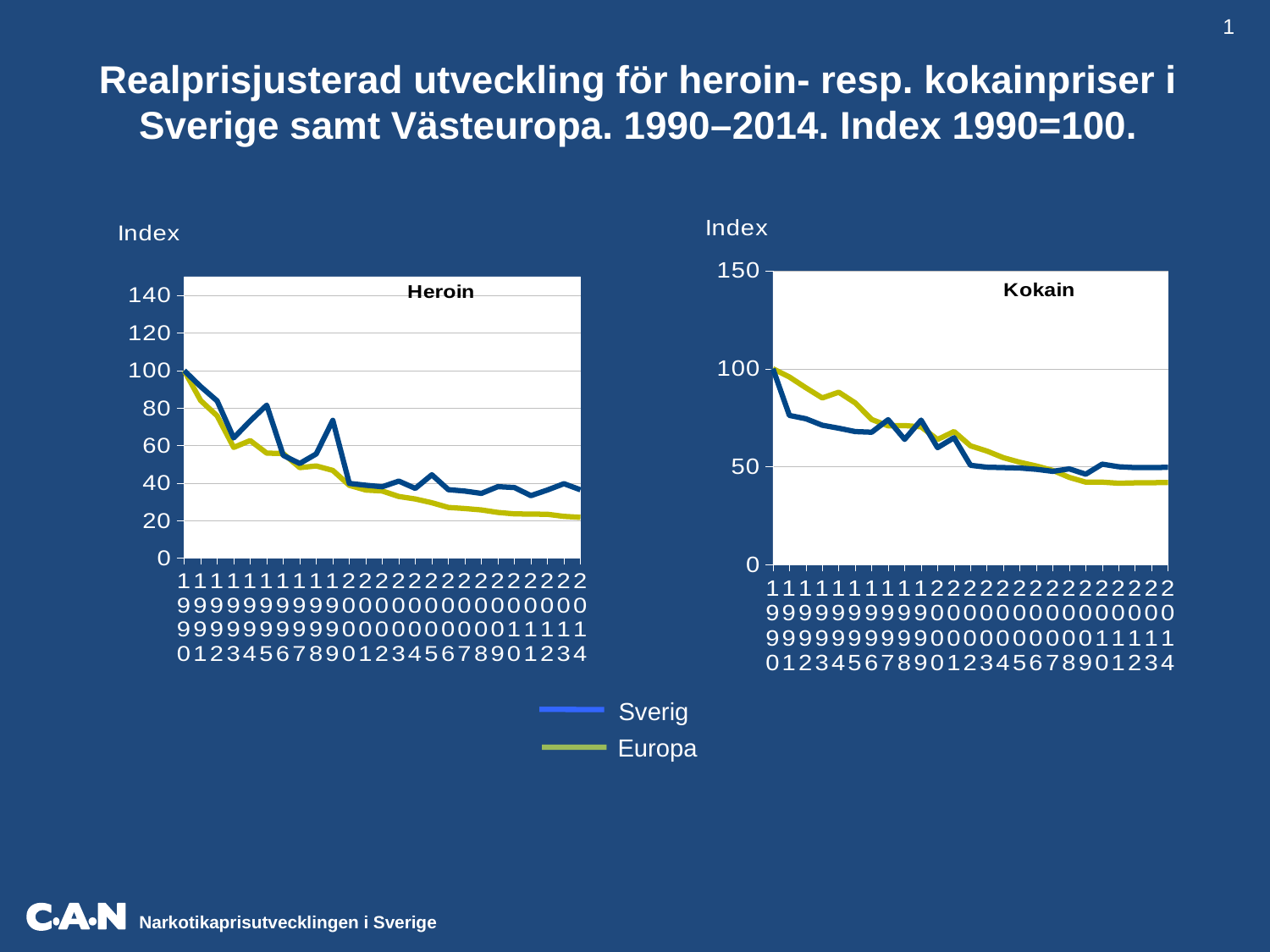
In the Kokain chart, do the values for Sverige rise or fall from 1990 to 2014? fall What kind of chart is the Heroin chart? line chart In the Heroin chart, do the values for Europa rise or fall from 1990 to 2014? fall In the Kokain chart, which series has the higher value in 1991, Sverige or Europa? Europa How many years are plotted on the x axis of the Kokain chart? 25 In the Heroin chart, is the value for Sverige in 1998 greater or less than 60? less In the Heroin chart, what is the index value for Sverige in 1990? 100 In the Kokain chart, is the value for Europa in 2014 greater or less than 50? less In the Heroin chart, is the value for Europa in 2014 greater or less than 40? less In the Heroin chart, which series has the higher value in 2014, Sverige or Europa? Sverige How many series does the legend list? 2 In the Kokain chart, what is the index value for Europa in 1990? 100